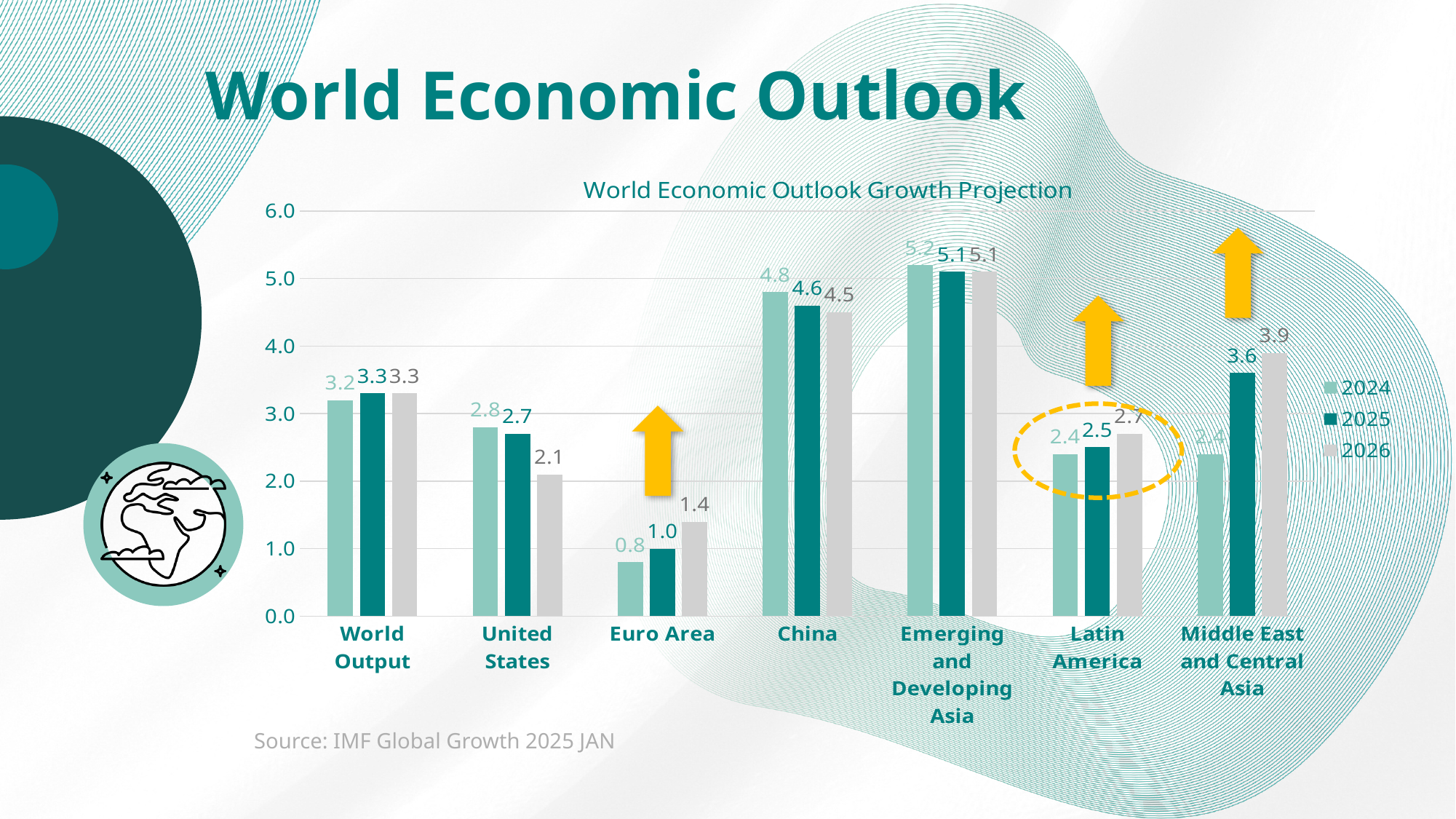
What is the title of the chart? World Economic Outlook Growth Projection Which category has the lowest 2025 value? Euro Area How many series does the legend list? 3 Is the 2026 value for Latin America greater or less than 3.0? less Which category has the highest 2024 value? Emerging and Developing Asia What is the 2025 value for China? 4.6 What kind of chart is shown? bar chart What is the 2026 value for Euro Area? 1.4 What is the 2024 value for Middle East and Central Asia? 2.4 How many categories are shown on the x axis? 7 What is the difference between the 2026 and 2024 values for Middle East and Central Asia? 1.5 Which is larger for United States: the 2024 value or the 2026 value? 2024